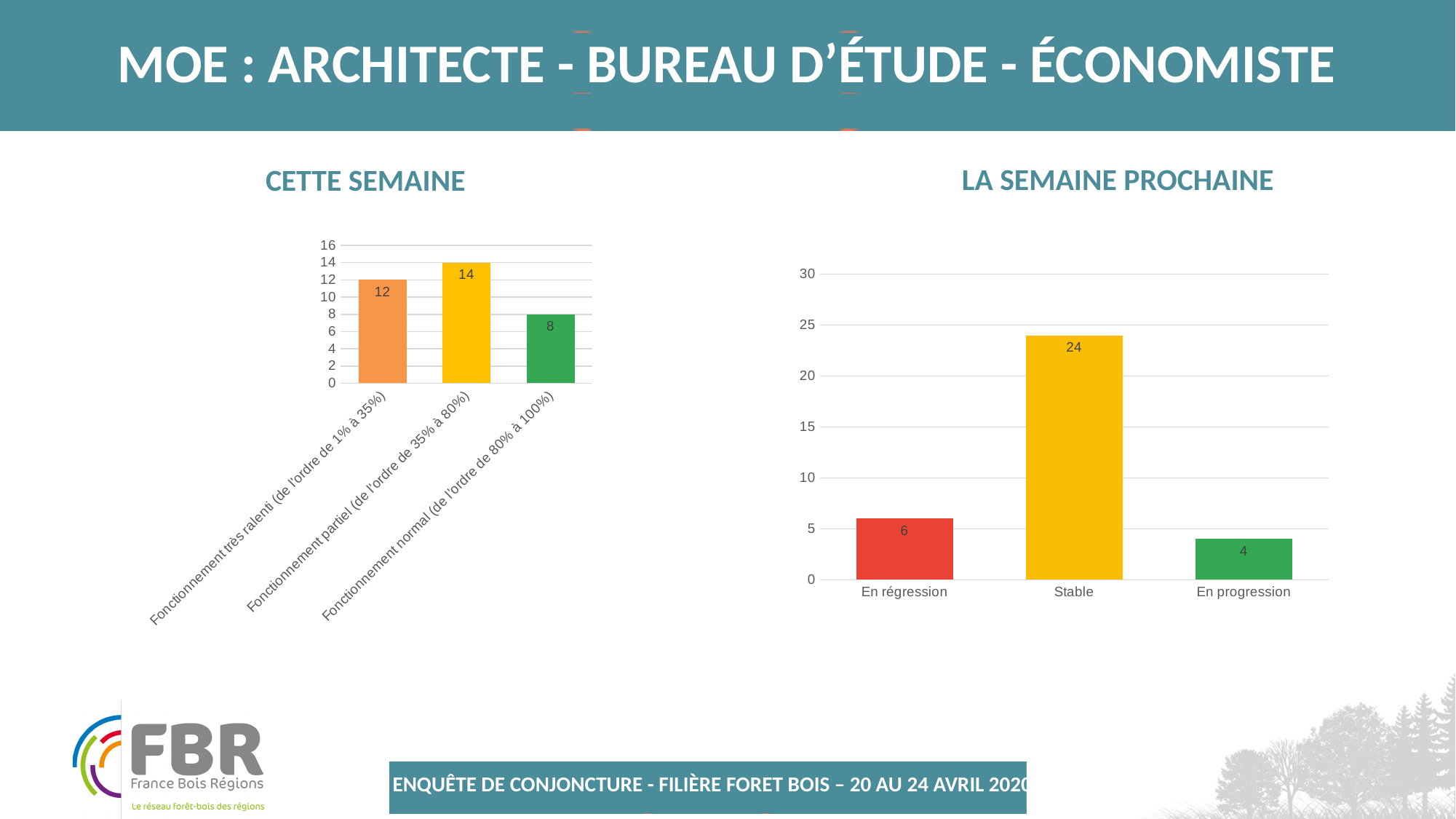
In the 'CETTE SEMAINE' chart, what is the difference between 'Fonctionnement très ralenti' and 'Fonctionnement normal'? 4 In the 'CETTE SEMAINE' chart, what is the value for 'Fonctionnement partiel (de l'ordre de 35% à 80%)'? 14 What type of chart is the 'LA SEMAINE PROCHAINE' chart? Bar chart In the 'LA SEMAINE PROCHAINE' chart, which category has the lowest value? En progression In the 'LA SEMAINE PROCHAINE' chart, which is larger: 'En régression' or 'En progression'? En régression In the 'LA SEMAINE PROCHAINE' chart, what is the value for 'En régression'? 6 In the 'CETTE SEMAINE' chart, which category has the highest value? Fonctionnement partiel (de l'ordre de 35% à 80%) In the 'CETTE SEMAINE' chart, what is the value for 'Fonctionnement normal (de l'ordre de 80% à 100%)'? 8 In the 'LA SEMAINE PROCHAINE' chart, what is the difference between 'Stable' and 'En régression'? 18 In the 'LA SEMAINE PROCHAINE' chart, what is the value for 'Stable'? 24 In the 'CETTE SEMAINE' chart, which category has the lowest value? Fonctionnement normal (de l'ordre de 80% à 100%) In the 'CETTE SEMAINE' chart, how many categories are shown? 3